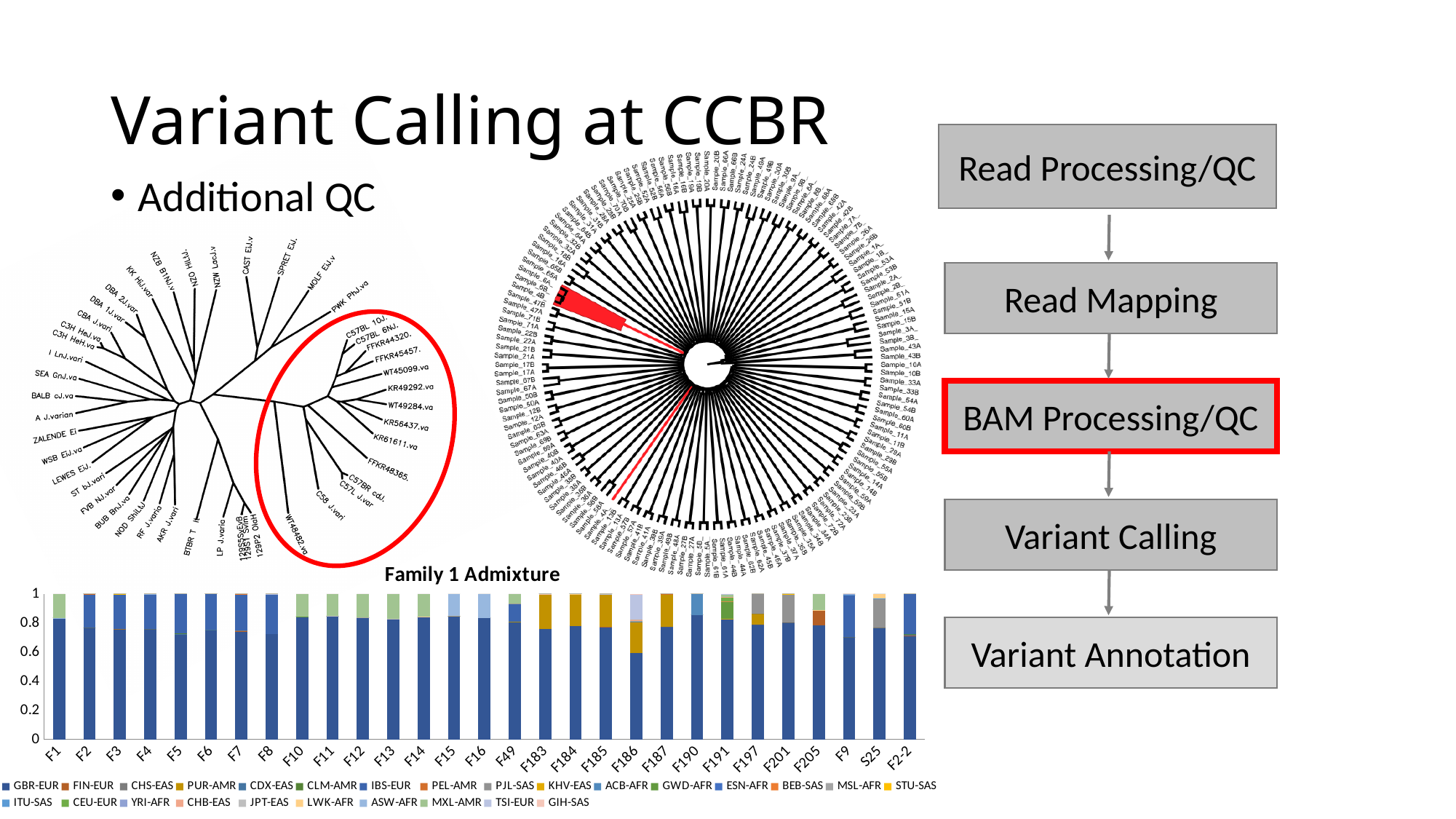
How many series does the legend of the Family 1 Admixture chart list? 26 In the Family 1 Admixture chart, what is the total height of the stacked bar for F1? 1 What is the title of the bar chart at the bottom of the slide? Family 1 Admixture In the Family 1 Admixture chart, which has the larger GBR-EUR segment, F2 or F186? F2 In the Family 1 Admixture chart, which category has the smallest GBR-EUR (dark blue) segment? F186 What is the maximum value shown on the y axis of the Family 1 Admixture chart? 1 In the Family 1 Admixture chart, is the GBR-EUR segment for F2-2 greater or less than 0.8? less How many categories (samples) are shown on the x axis of the Family 1 Admixture chart? 29 In the Family 1 Admixture chart, is the GBR-EUR segment for F186 greater or less than 0.8? less What kind of chart is the Family 1 Admixture chart? Stacked bar chart